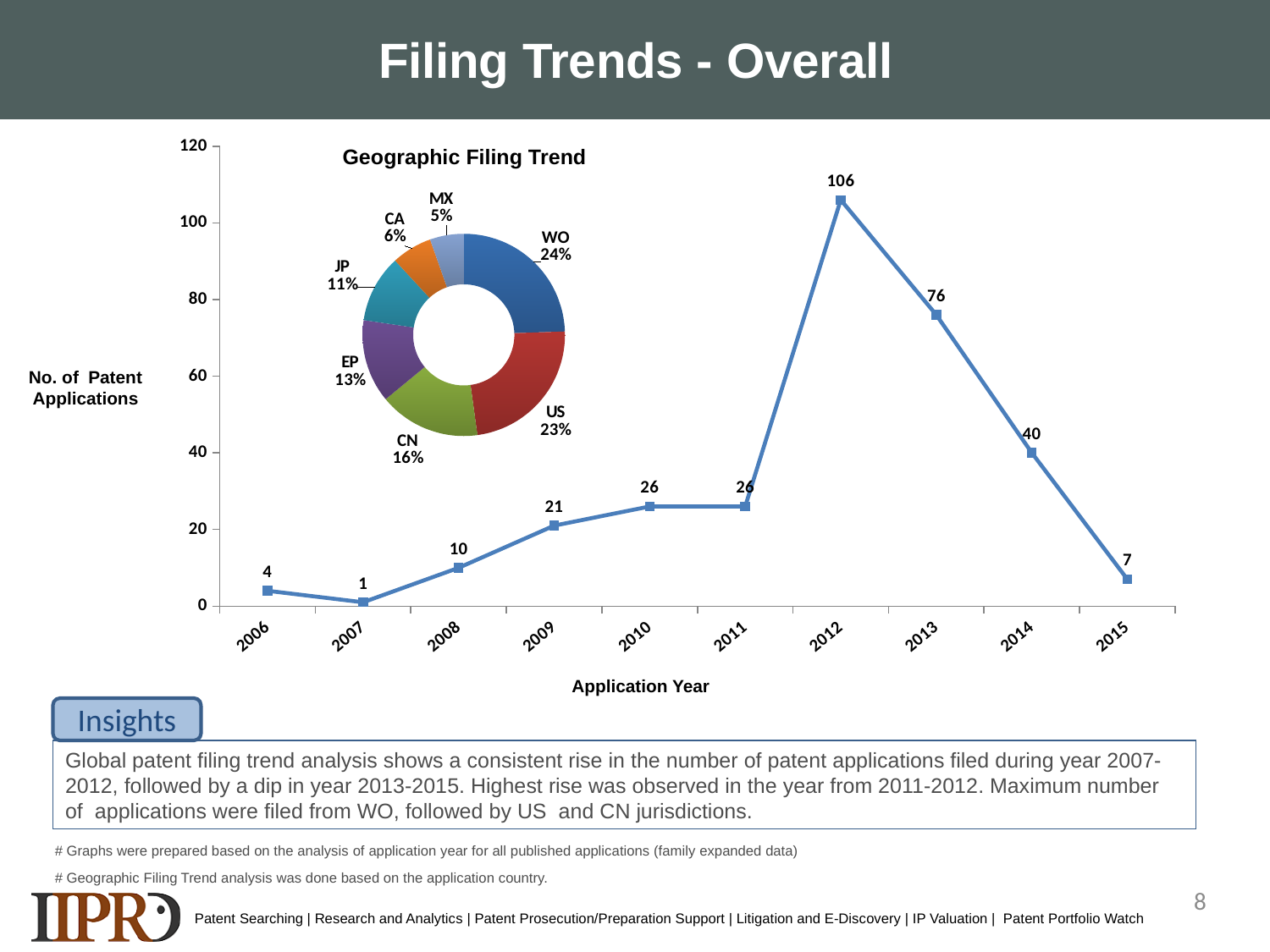
In the line chart of patent applications by application year, what is the difference between the number of applications in 2012 and 2013? 30 In the line chart of patent applications by application year, do the values rise or fall from 2012 to 2015? fall What type of chart is the Geographic Filing Trend chart? doughnut chart In the Geographic Filing Trend chart, what share of filings is from CN? 16% In the line chart of patent applications by application year, how many patent applications were filed in 2012? 106 In the line chart of patent applications by application year, how many years are shown on the x axis? 10 In the Geographic Filing Trend chart, which jurisdiction has the smallest share? MX In the line chart of patent applications by application year, which year has the highest number of patent applications? 2012 In the Geographic Filing Trend chart, what share of filings is from WO? 24% In the line chart of patent applications by application year, which year had more applications, 2014 or 2015? 2014 In the line chart of patent applications by application year, how many patent applications were filed in 2009? 21 In the line chart of patent applications by application year, which year has the lowest number of patent applications? 2007